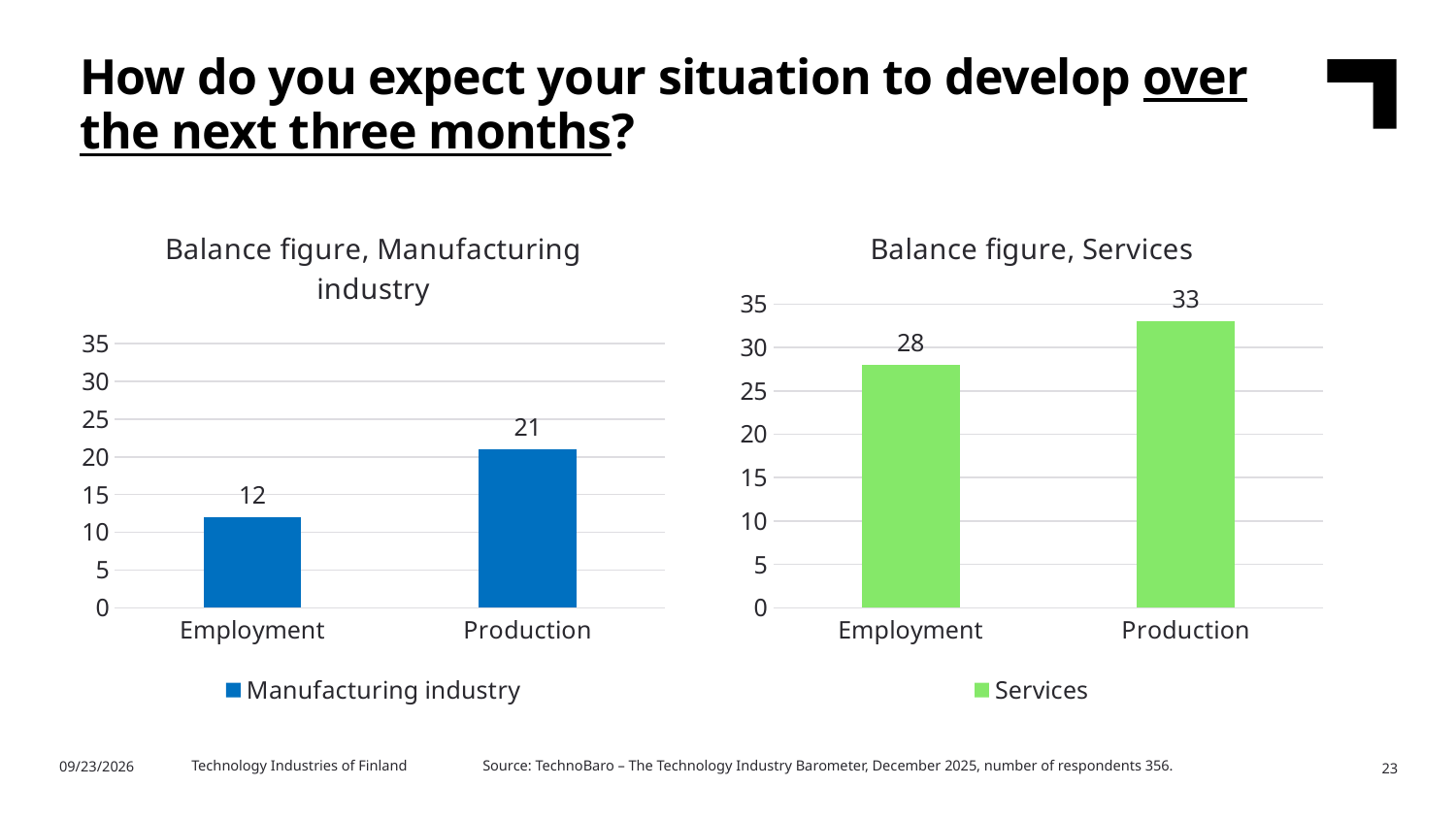
In the 'Balance figure, Manufacturing industry' chart, what is the value for Production? 21 In the 'Balance figure, Services' chart, what is the value for Employment? 28 What type of chart is the 'Balance figure, Manufacturing industry' chart? bar chart How many categories are shown in the 'Balance figure, Services' chart? 2 In the 'Balance figure, Services' chart, what is the difference between the Production and Employment values? 5 Is the Employment value in the 'Balance figure, Services' chart larger or smaller than the Employment value in the 'Balance figure, Manufacturing industry' chart? larger In the 'Balance figure, Services' chart, which category has the lowest value? Employment In the 'Balance figure, Manufacturing industry' chart, which category has the highest value? Production In the 'Balance figure, Services' chart, what is the value for Production? 33 In the 'Balance figure, Manufacturing industry' chart, what is the value for Employment? 12 In the 'Balance figure, Manufacturing industry' chart, what is the difference between the Production and Employment values? 9 In the 'Balance figure, Manufacturing industry' chart, is the value for Production greater or less than 25? less